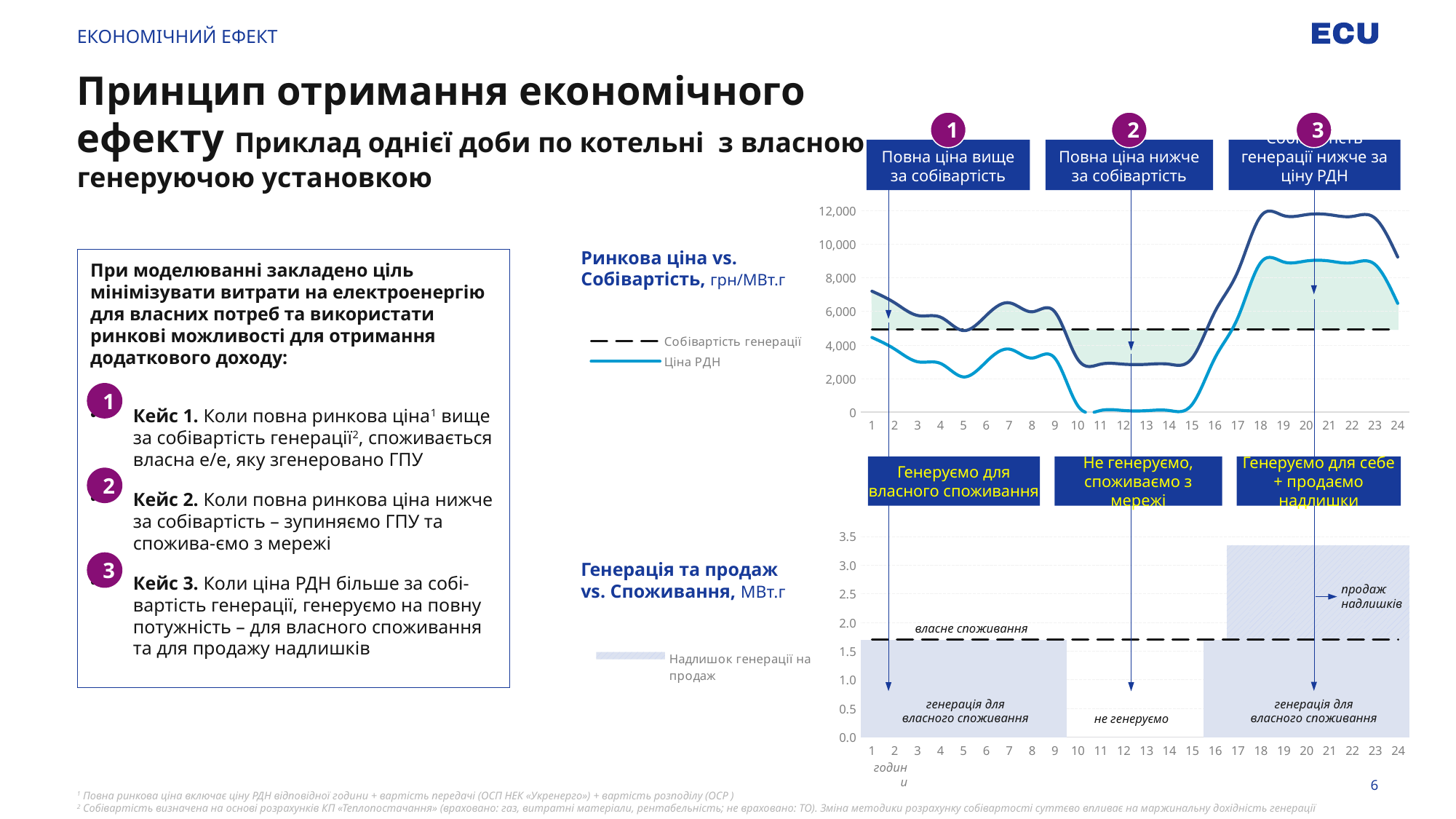
In the top chart 'Ринкова ціна vs. Собівартість', is the value of Ціна РДН at hour 12 greater or less than 2,000? less In the top chart 'Ринкова ціна vs. Собівартість', does Ціна РДН rise or fall from hour 15 to hour 18? rise What kind of chart is the top chart titled 'Ринкова ціна vs. Собівартість'? line chart In the bottom chart 'Генерація та продаж vs. Споживання', how many entries does the legend list? 1 In the top chart 'Ринкова ціна vs. Собівартість', how many hours are shown on the x axis? 24 In the bottom chart 'Генерація та продаж vs. Споживання', is the dashed 'власне споживання' line greater or less than 2.0? less In the top chart 'Ринкова ціна vs. Собівартість', which is larger: Ціна РДН at hour 1 or Ціна РДН at hour 12? hour 1 In the top chart 'Ринкова ціна vs. Собівартість', is the value of Ціна РДН at hour 18 greater or less than 8,000? greater In the top chart 'Ринкова ціна vs. Собівартість', how many series does the legend list? 2 What unit is given in the title of the top chart 'Ринкова ціна vs. Собівартість'? грн/МВт.г